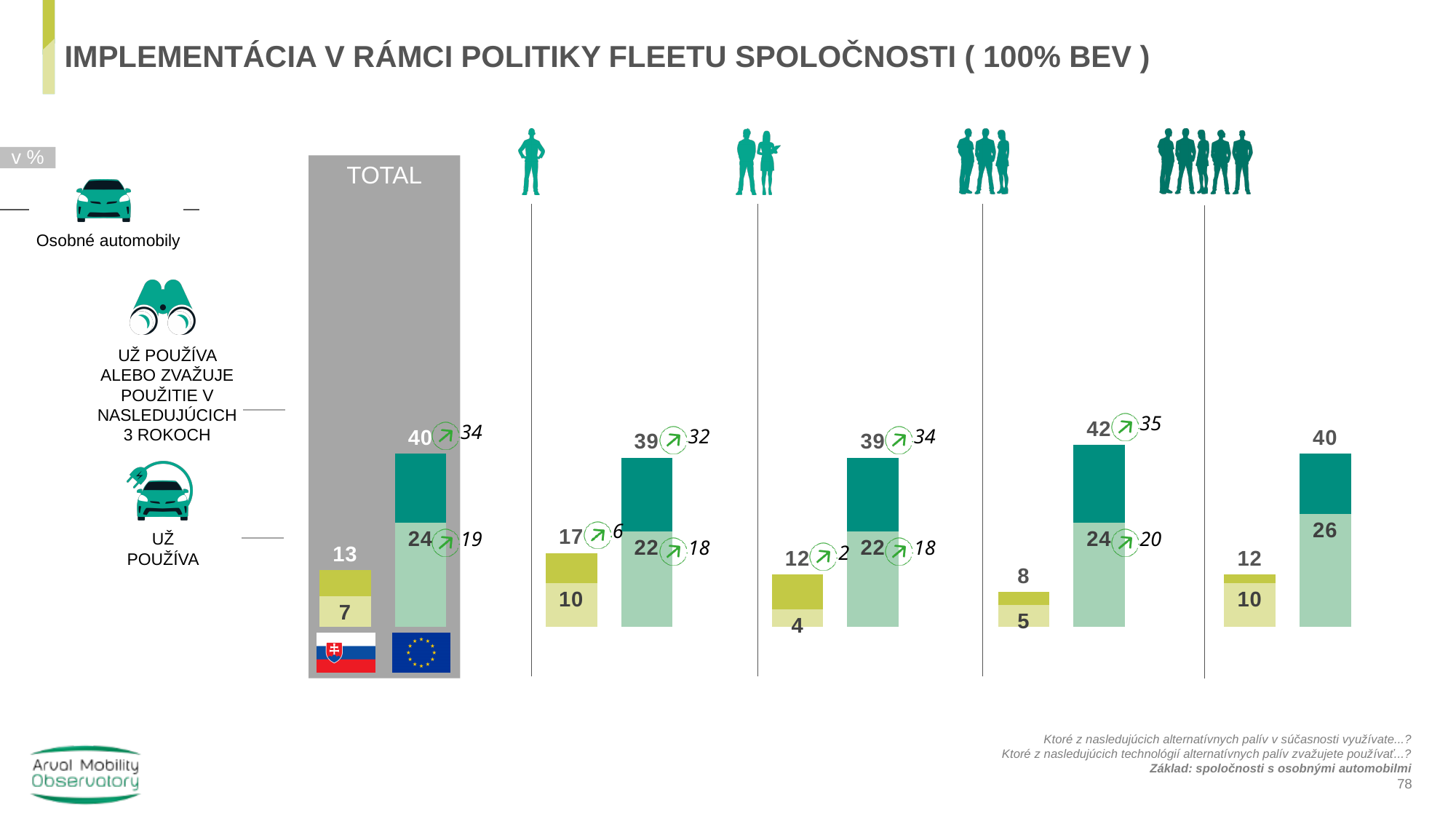
In the first company-size group (single-person icon), what is the Slovakia value for 'už používa'? 10 Across the four company-size groups, which group has the highest EU value for 'už používa alebo zvažuje použitie v nasledujúcich 3 rokoch'? The third group (three-person icon), 42 What type of chart is shown on the slide? Bar chart In the TOTAL column, what is the Slovakia value for 'už používa alebo zvažuje použitie v nasledujúcich 3 rokoch'? 13 How many company-size groups are shown to the right of the TOTAL column? 4 What unit are the values on the chart expressed in, according to the label at the top left? % In the rightmost company-size group (five-person icon), what is the Slovakia value for 'už používa'? 10 Across the four company-size groups, which group has the lowest Slovakia value for 'už používa'? The second group (two-person icon), 4 In the TOTAL column, what is the difference between the EU and Slovakia values for 'už používa alebo zvažuje použitie v nasledujúcich 3 rokoch'? 27 In the TOTAL column, what is the EU value for 'už používa alebo zvažuje použitie v nasledujúcich 3 rokoch'? 40 In the TOTAL column, what is the EU value for 'už používa'? 24 In the third company-size group (three-person icon), which is larger: the Slovakia value (8) or the EU value (42) for 'už používa alebo zvažuje'? EU (42)